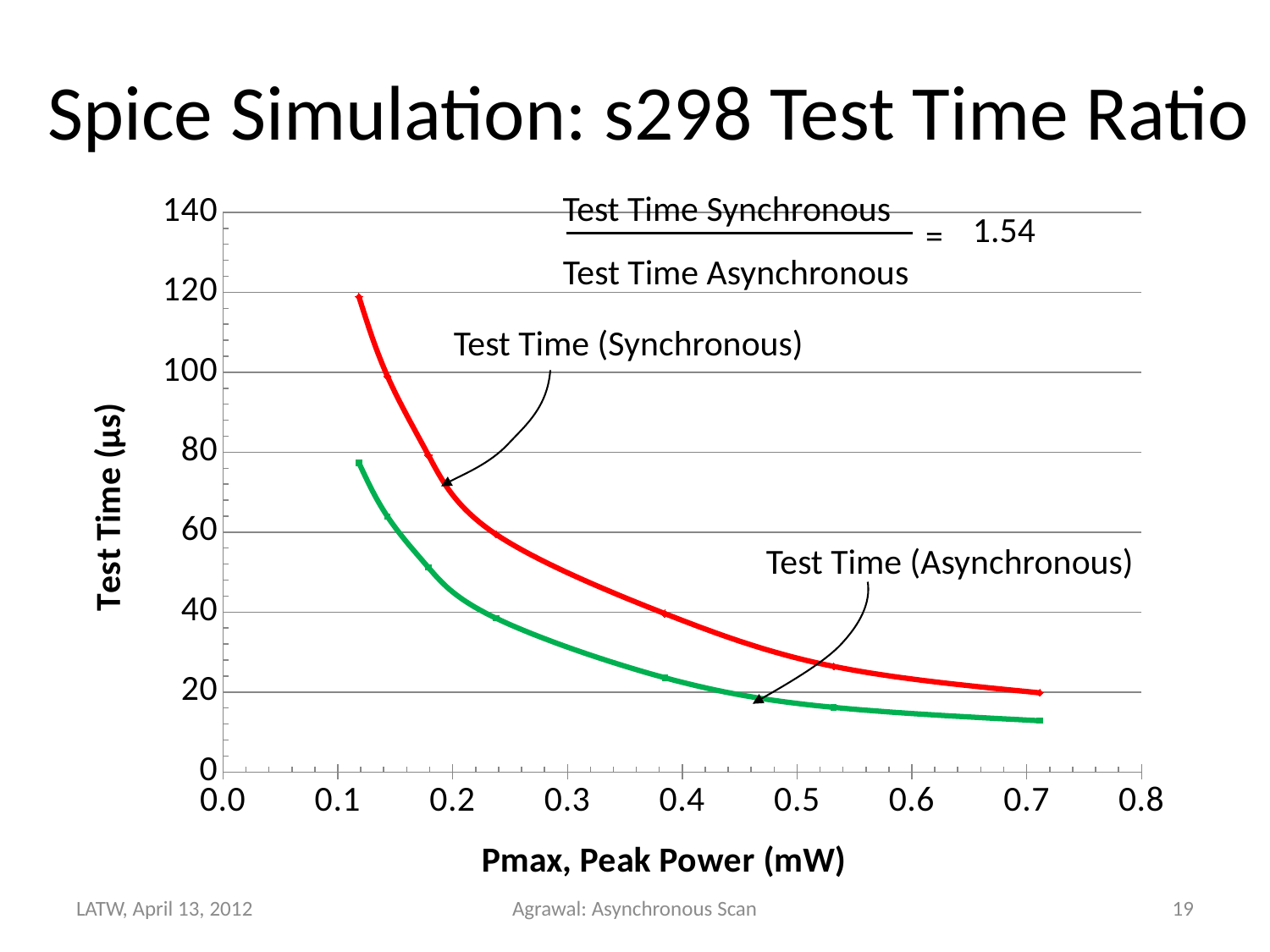
What ratio of Test Time Synchronous to Test Time Asynchronous is stated on the chart? 1.54 Is the Test Time (Synchronous) value at the lowest plotted Pmax greater or less than 100? greater What kind of chart is shown on the slide? line chart What is the title of the slide's chart? Spice Simulation: s298 Test Time Ratio Is the Test Time (Asynchronous) value at the lowest plotted Pmax greater or less than 60? greater Which curve has the higher test time at a Pmax of 0.2 mW, Synchronous or Asynchronous? Synchronous Does the Test Time (Synchronous) curve rise or fall as Pmax increases? fall How many series are plotted on the chart? 2 Is the Test Time (Asynchronous) value at a Pmax of 0.7 mW greater or less than 20? less Does the Test Time (Asynchronous) curve rise or fall as Pmax increases? fall What is the label of the x axis? Pmax, Peak Power (mW)